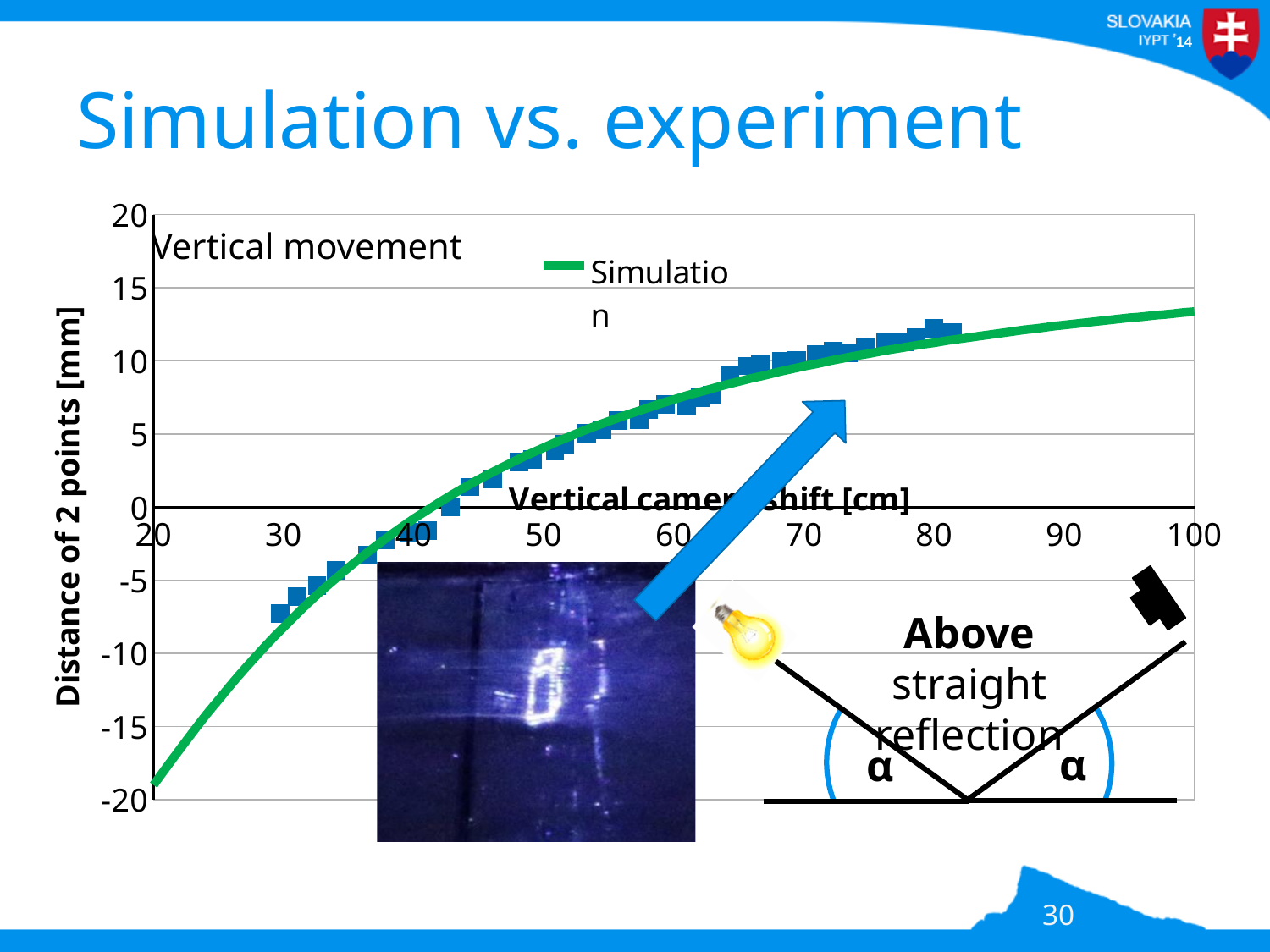
Is the simulation value at a vertical camera shift of 80 cm greater or less than 10? greater What is the title of the chart? Vertical movement Is the simulation value at a vertical camera shift of 20 cm greater or less than -15? less What is the highest value shown on the x axis of the chart? 100 Is the simulation value at a vertical camera shift of 50 cm greater or less than 0? greater What is the label of the y axis of the chart? Distance of 2 points [mm] Which is larger on the simulation curve: the value at 40 cm or the value at 70 cm? 70 cm Does the simulation curve rise or fall as the vertical camera shift increases along the x axis? rise How many series does the chart's legend list? 1